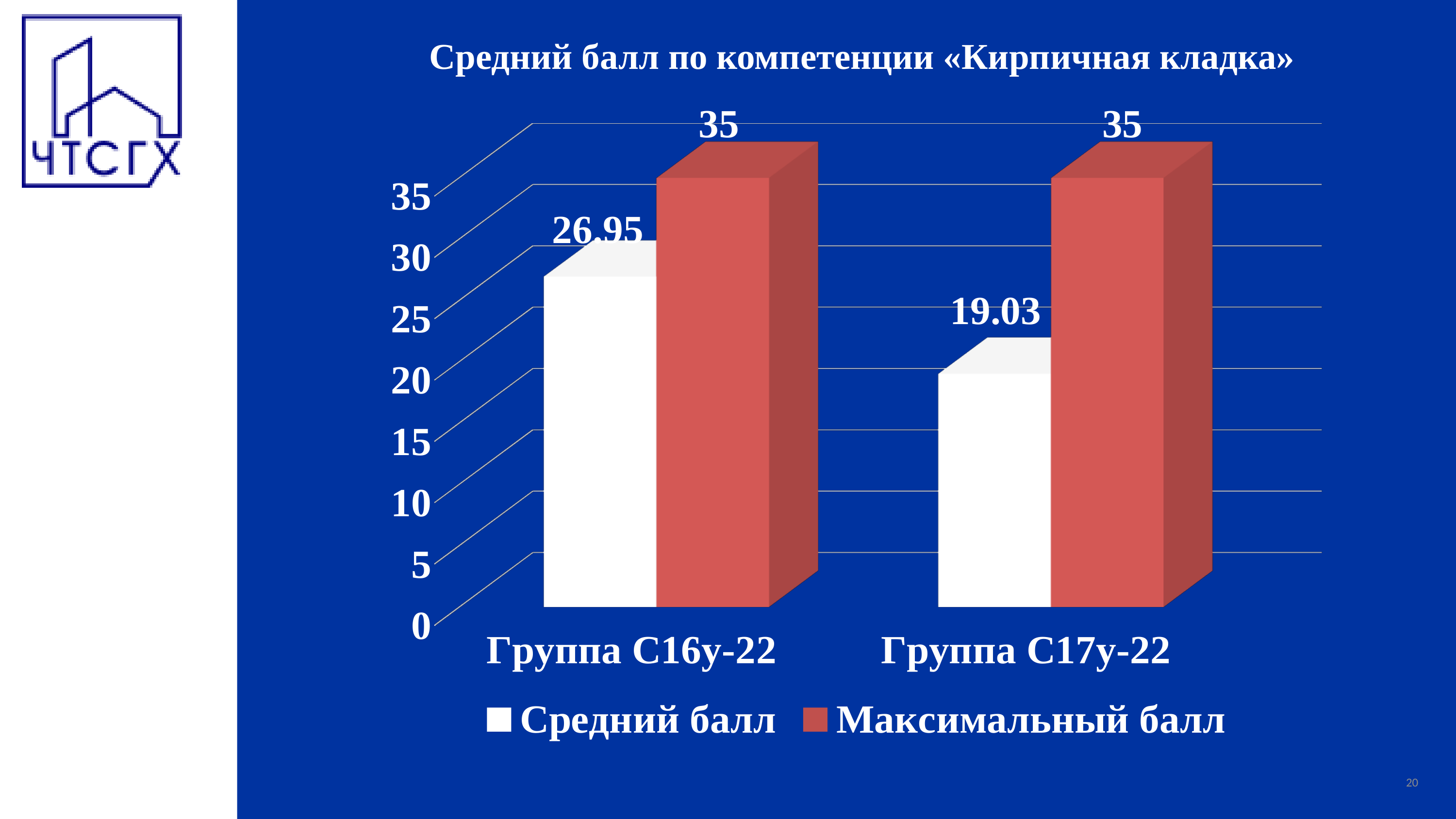
What is the Средний балл for Группа С16у-22? 26.95 Is the Средний балл for Группа С16у-22 greater or less than 25? greater How many series does the legend list? 2 What is the Средний балл for Группа С17у-22? 19.03 What is the difference between the Средний балл of Группа С16у-22 and Группа С17у-22? 7.92 Which group has the lower Средний балл? Группа С17у-22 What is the Максимальный балл for Группа С16у-22? 35 How many groups are shown on the x axis? 2 For Группа С17у-22, what is the difference between the Максимальный балл and the Средний балл? 15.97 Is the Средний балл for Группа С17у-22 greater or less than 20? less What kind of chart is shown on the slide? Bar chart Which group has the higher Средний балл? Группа С16у-22